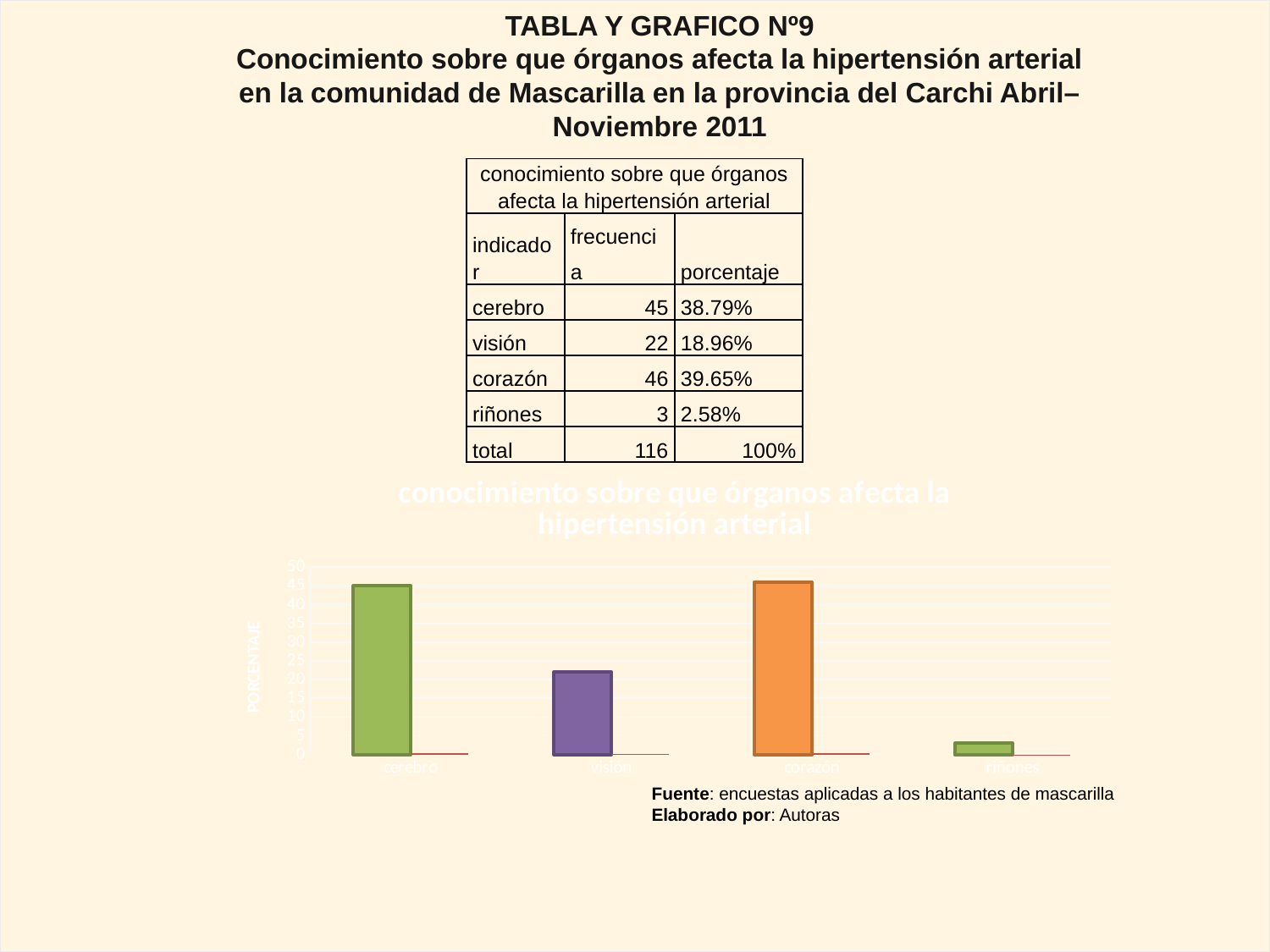
According to the table, what is the percentage for corazón? 39.65% Is the bar for visión greater or less than 25? less According to the table, what is the frequency for cerebro? 45 What kind of chart is shown on the slide? bar chart How many categories are plotted on the x axis of the chart? 4 Which bar is taller, visión or riñones? visión Is the bar for corazón greater or less than 40? greater Is the bar for cerebro greater or less than 40? greater What colour is the bar for corazón? orange Which category has the lowest bar in the chart? riñones According to the table, what is the difference in frequency between corazón and cerebro? 1